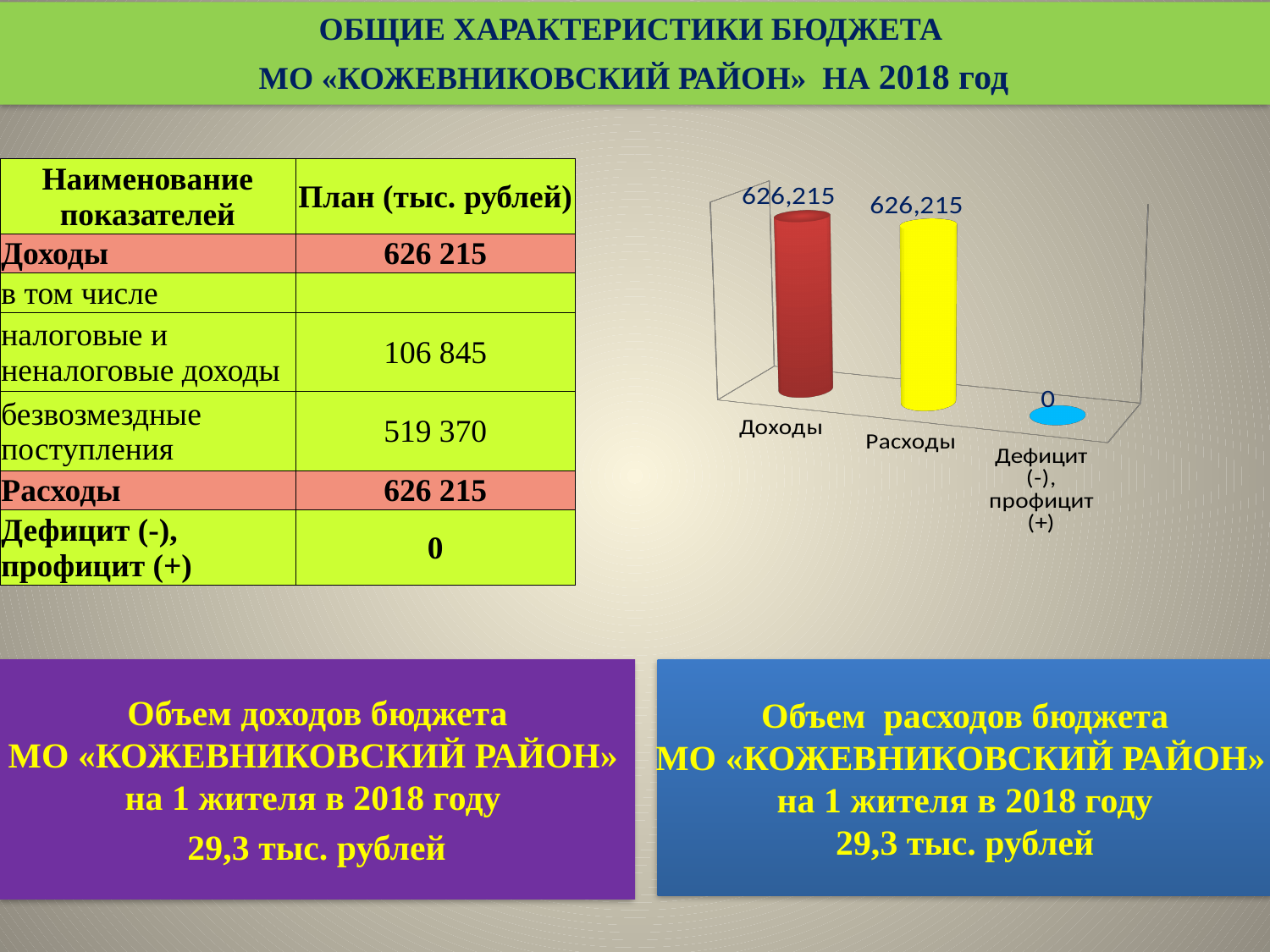
What kind of chart is shown on the slide? bar chart What value is shown for Расходы in the chart? 626,215 What colour is the bar for Доходы in the chart? red What value is shown for Доходы in the chart? 626,215 What is the difference between the values for Доходы and Расходы in the chart? 0 Which category has the lowest value in the chart? Дефицит (-), профицит (+) How many categories are plotted in the chart? 3 What value is shown for Дефицит (-), профицит (+) in the chart? 0 What is the difference between the values for Доходы and Дефицит (-), профицит (+) in the chart? 626,215 What colour is the bar for Расходы in the chart? yellow Which is larger in the chart, the value for Расходы or the value for Дефицит (-), профицит (+)? Расходы